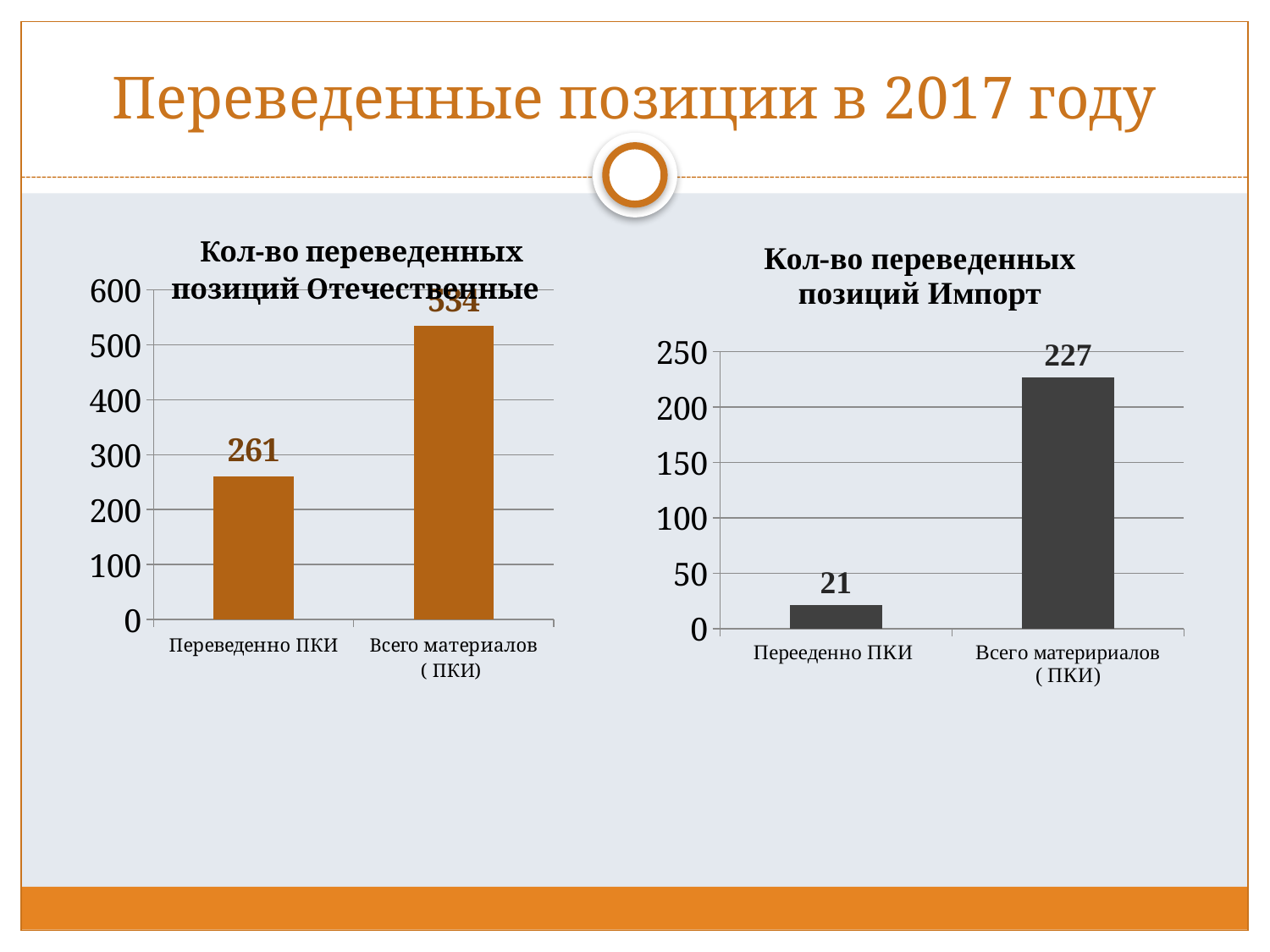
In the chart titled "Кол-во переведенных позиций Импорт", what is the value for "Всего материриалов (ПКИ)"? 227 In the chart titled "Кол-во переведенных позиций Импорт", which category has the lowest value? Перееденно ПКИ In the chart titled "Кол-во переведенных позиций Отечественные", which category has the highest value? Всего материалов (ПКИ) In the chart titled "Кол-во переведенных позиций Отечественные", what is the difference between the two bars? 273 What is the title of the chart on the right side of the slide? Кол-во переведенных позиций Импорт In the chart titled "Кол-во переведенных позиций Импорт", what is the value for "Перееденно ПКИ"? 21 In the chart titled "Кол-во переведенных позиций Отечественные", what is the value for "Всего материалов (ПКИ)"? 534 In the chart titled "Кол-во переведенных позиций Отечественные", what is the value for "Переведенно ПКИ"? 261 How many bars are in the chart titled "Кол-во переведенных позиций Отечественные"? 2 In the chart titled "Кол-во переведенных позиций Импорт", what is the difference between the two bars? 206 In the chart titled "Кол-во переведенных позиций Импорт", is the value for "Всего материриалов (ПКИ)" greater or less than 200? greater What type of chart is the chart titled "Кол-во переведенных позиций Импорт"? bar chart